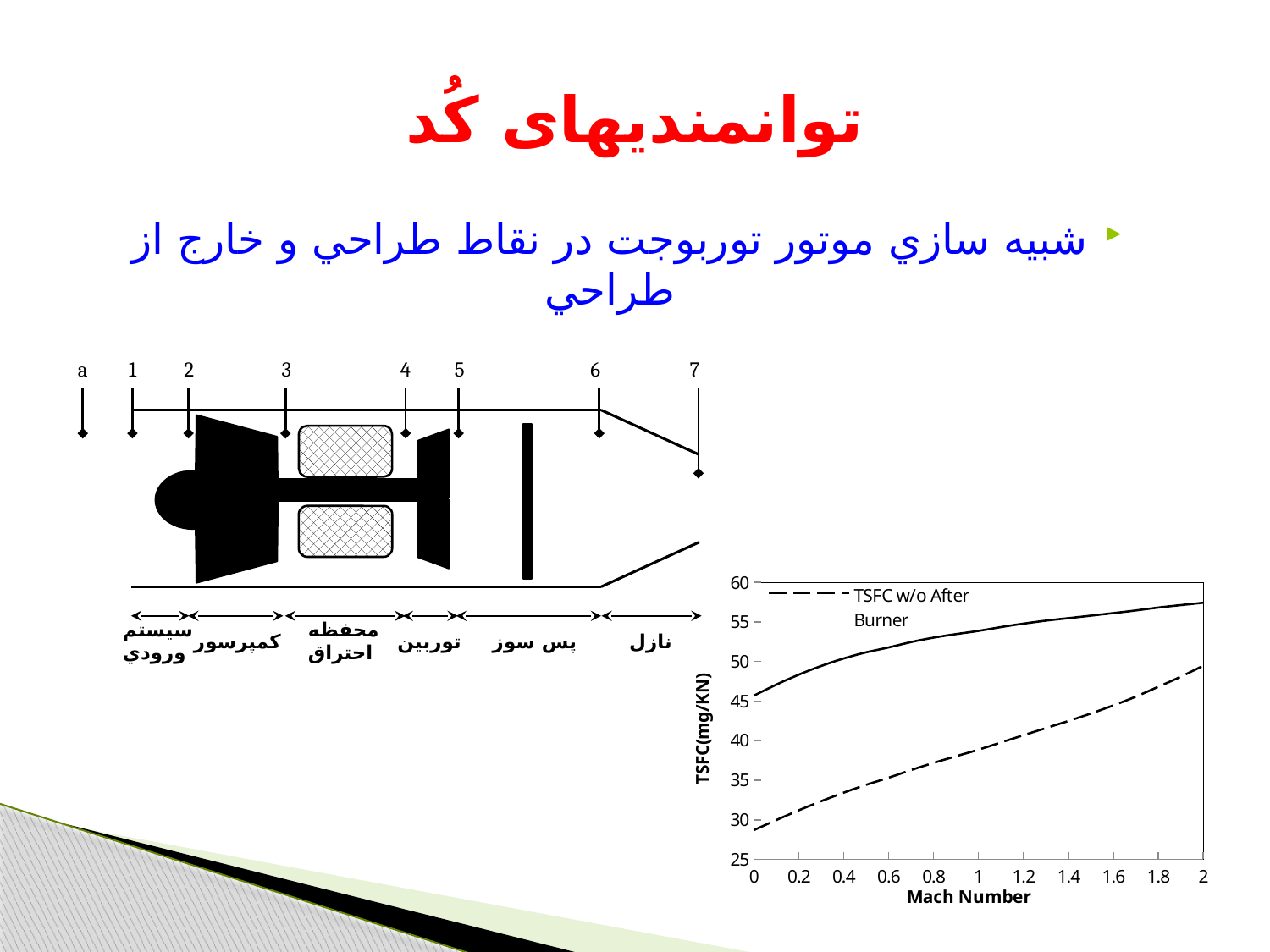
Does the dashed line (TSFC w/o After Burner) rise or fall as Mach Number increases? rise Is the value of the dashed line (TSFC w/o After Burner) at Mach Number 2 greater or less than 45? greater Is the value of the solid line at Mach Number 0 greater or less than 50? less What is the label of the x axis of the chart? Mach Number Is the value of the dashed line (TSFC w/o After Burner) at Mach Number 0 greater or less than 30? less Does the solid line rise or fall as Mach Number increases from 0 to 2? rise What is the label of the y axis of the chart? TSFC(mg/KN) What kind of chart is shown at the bottom right of the slide? line chart How many series does the legend of the chart list? 1 At Mach Number 1, which line has the higher TSFC value, the solid line or the dashed line? the solid line